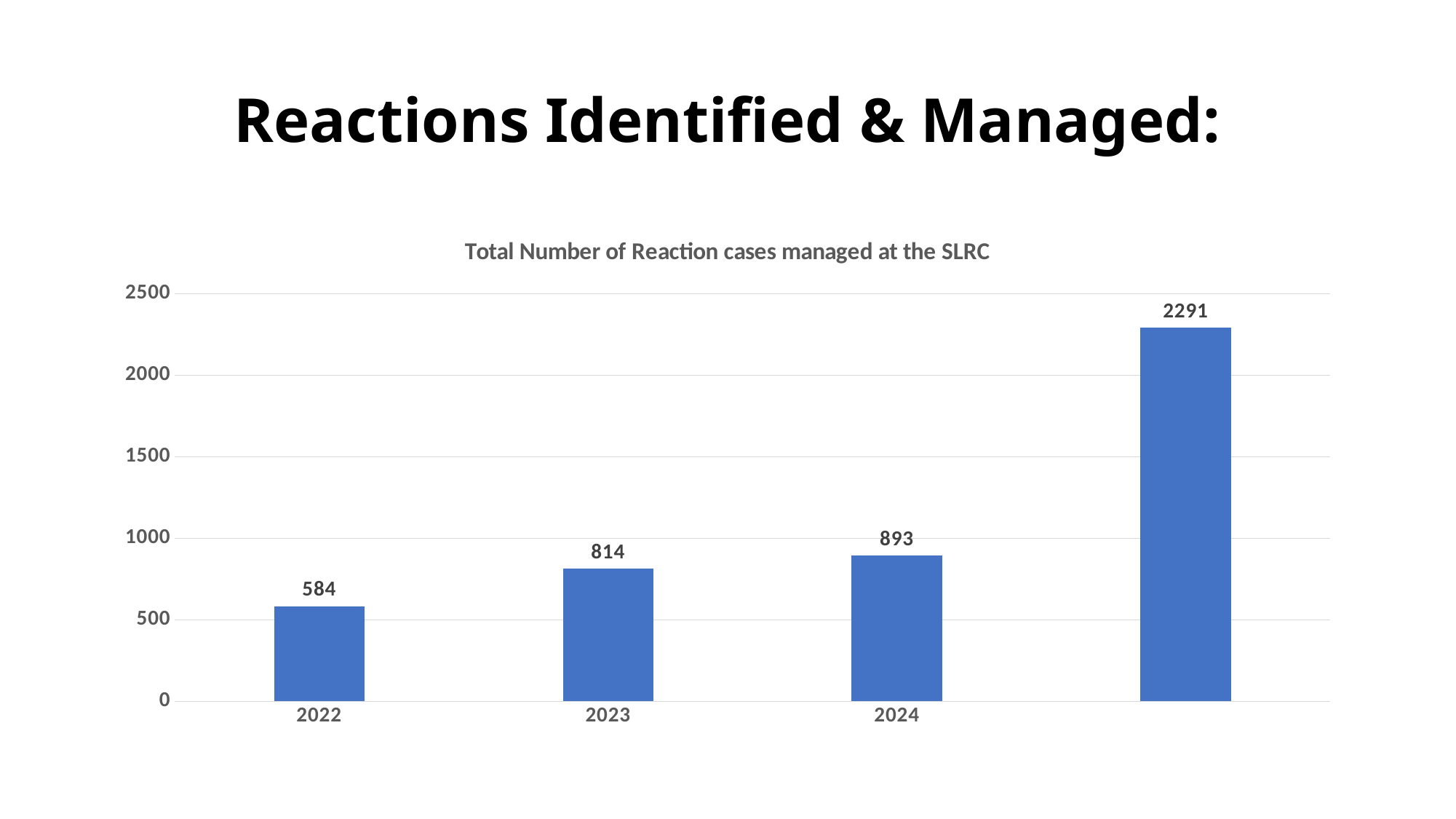
Which is larger, the value for 2024 or the value for 2023? 2024 What is the value for 2023? 814 What is the value for 2024? 893 What is the difference between the values for 2024 and 2023? 79 Which year has the lowest value among the labelled years? 2022 Do the values rise or fall from left to right along the x axis? rise What is the value for 2022? 584 How many bars are plotted on the chart? 4 What is the difference between the values for 2023 and 2022? 230 What kind of chart is shown on the slide? bar chart Is the value for 2022 greater or less than 1000? less What is the highest value shown on the chart? 2291